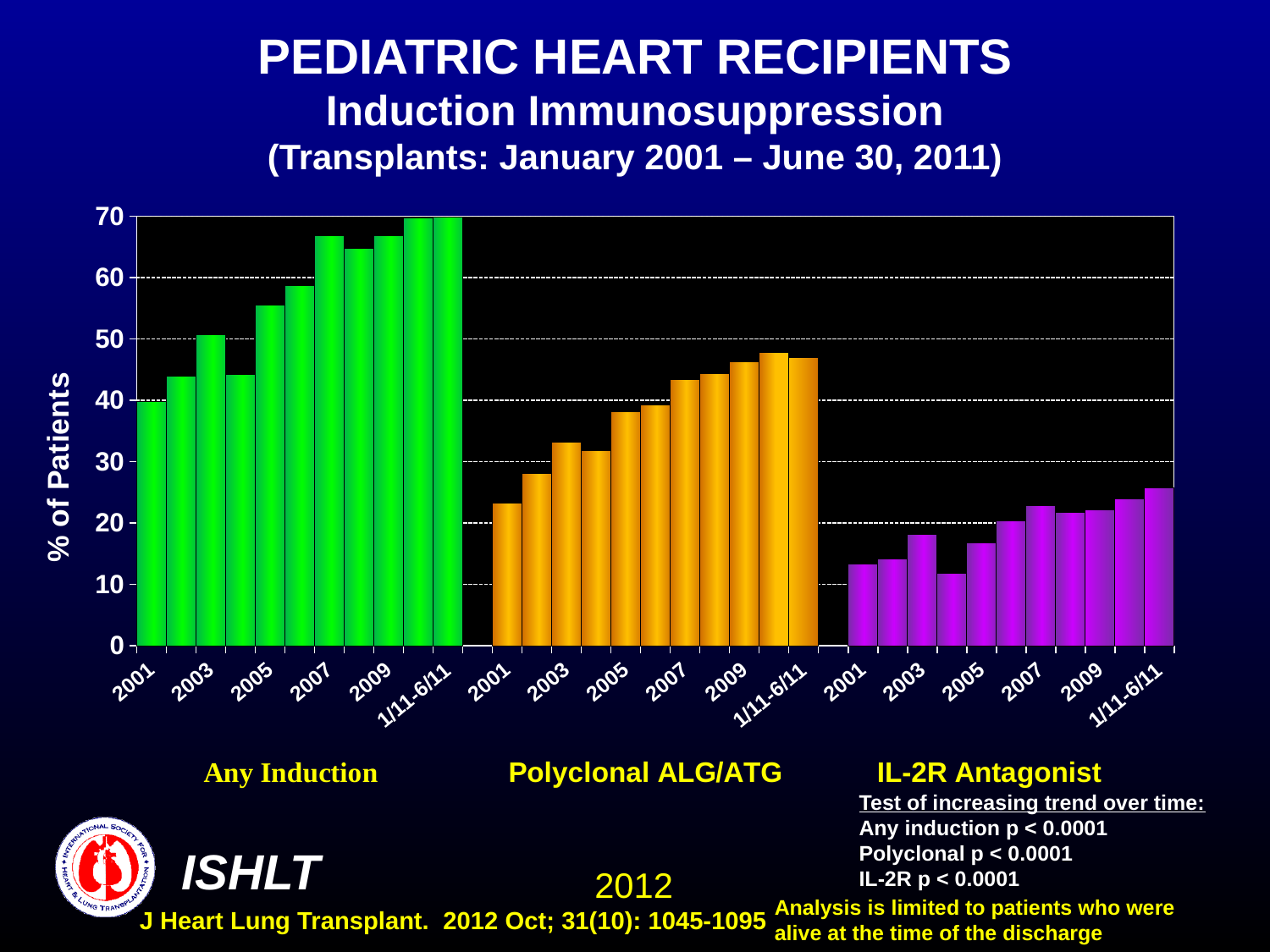
How many induction groups are shown on the chart? 3 Overall, do the IL-2R Antagonist values rise or fall from 2001 to 1/11-6/11? rise Is the Any Induction value for 2007 greater or less than 60? greater What is the label on the y axis of the chart? % of Patients Which year has the lowest value in the Any Induction group? 2001 Which year has the lowest value in the Polyclonal ALG/ATG group? 2001 Which period has the highest value in the IL-2R Antagonist group? 1/11-6/11 In the Any Induction group, which is larger, the value for 2003 or the value for 2004? 2003 Is the IL-2R Antagonist value for 2007 greater or less than 20? greater What kind of chart is shown on the slide? bar chart How many bars are plotted in the Any Induction group? 11 Is the Polyclonal ALG/ATG value for 2001 greater or less than 30? less